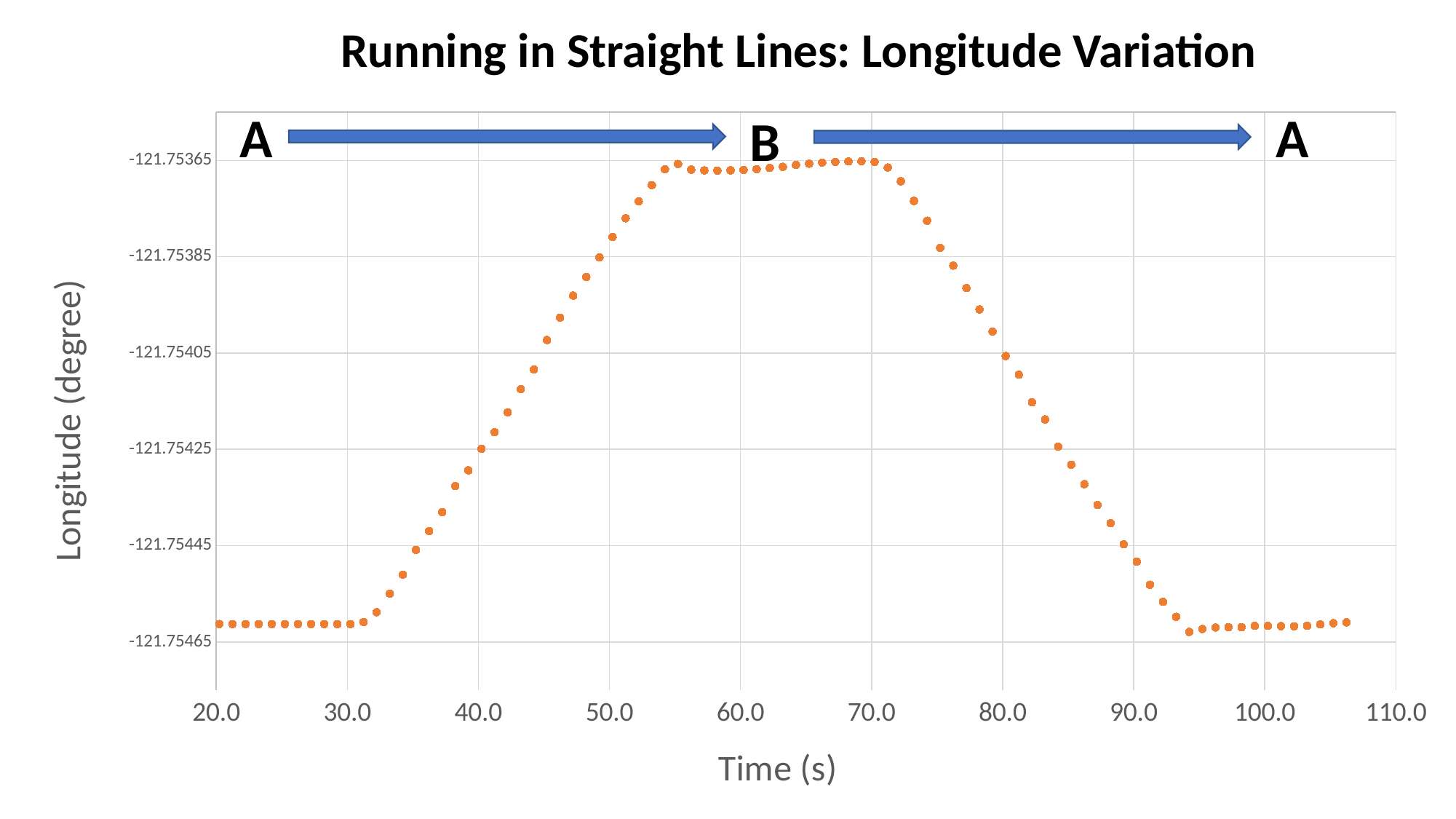
Is the longitude value at 45.0 s greater or less than -121.75385? less Is the longitude value at 75.0 s greater or less than -121.75405? greater Between 70.0 s and 95.0 s, do the longitude values rise or fall as time increases? fall Which is larger, the longitude value at 40.0 s or the longitude value at 80.0 s? 80.0 s What is the label of the vertical axis? Longitude (degree) What is the title of the chart? Running in Straight Lines: Longitude Variation Is the longitude value at 60.0 s greater or less than -121.75385? greater Between 30.0 s and 55.0 s, do the longitude values rise or fall as time increases? rise Which is larger, the longitude value at 60.0 s or the longitude value at 30.0 s? 60.0 s What kind of chart is shown on the slide? scatter chart